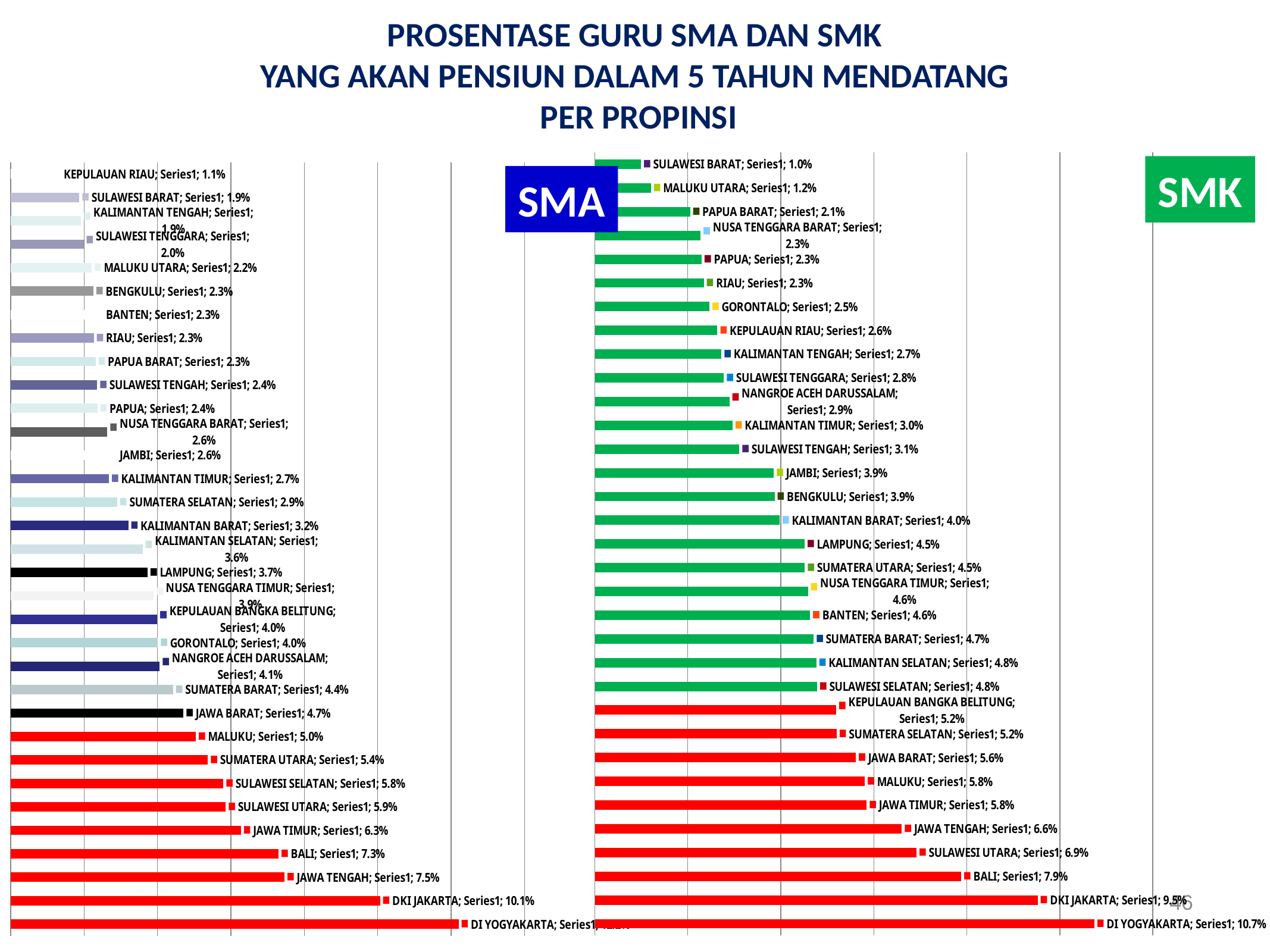
How many provinces are shown in the SMK chart? 33 In the SMK chart, which province has the lowest value? SULAWESI BARAT In the SMA chart, what is the value for DKI JAKARTA? 10.1% What type of chart is the SMA chart? Bar chart In the SMK chart, what is the value for KALIMANTAN TIMUR? 3.0% In the SMA chart, what is the value for LAMPUNG? 3.7% In the SMA chart, what is the difference between JAWA TENGAH and BALI? 0.2% In the SMA chart, which province has the lowest value? KEPULAUAN RIAU In the SMK chart, which province has the highest value? DI YOGYAKARTA In the SMK chart, what is the difference between DI YOGYAKARTA and DKI JAKARTA? 1.2% In the SMK chart, what is the value for BALI? 7.9% In the SMA chart, which is larger: SUMATERA UTARA or MALUKU? SUMATERA UTARA